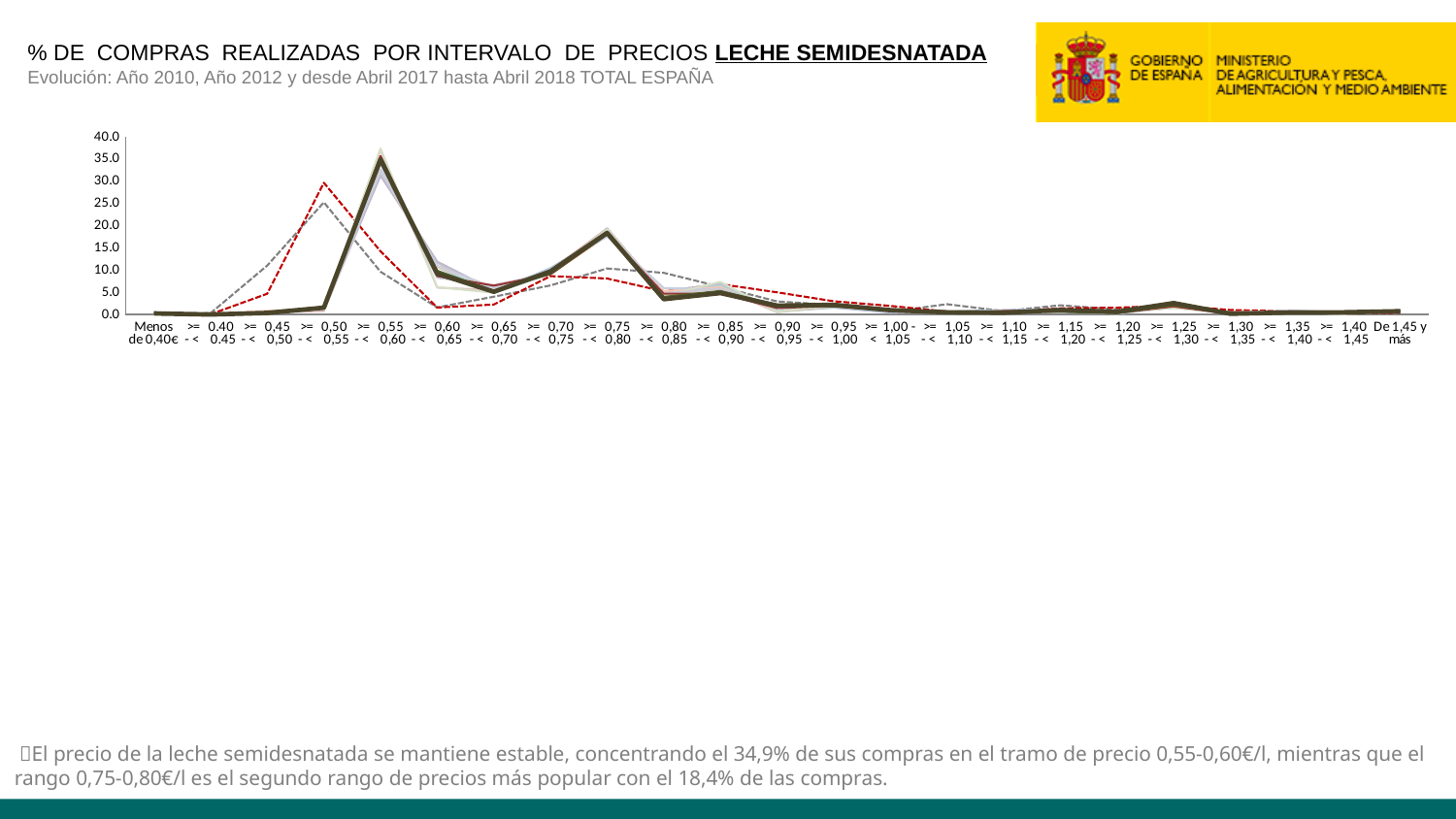
After the peak at '>= 0,55 - < 0,60', do the values generally rise or fall as the price intervals increase toward 'De 1,45 y más'? fall What is the highest value shown on the y axis of the chart? 40.0 Is the value for the interval '>= 1,20 - < 1,25' greater or less than 5.0? less According to the slide text, what percentage of purchases falls in the 0,75-0,80€/l price range? 18,4% In which price interval does the chart reach its highest point? >= 0,55 - < 0,60 Is the value for the interval 'Menos de 0,40€' greater or less than 5.0? less Is the highest point on the chart greater or less than 30.0? greater Which product is named in the chart title? LECHE SEMIDESNATADA How many price intervals are shown along the x axis of the chart? 23 What type of chart is shown on the slide? line chart According to the slide text, what percentage of semi-skimmed milk purchases falls in the 0,55-0,60€/l price range? 34,9%